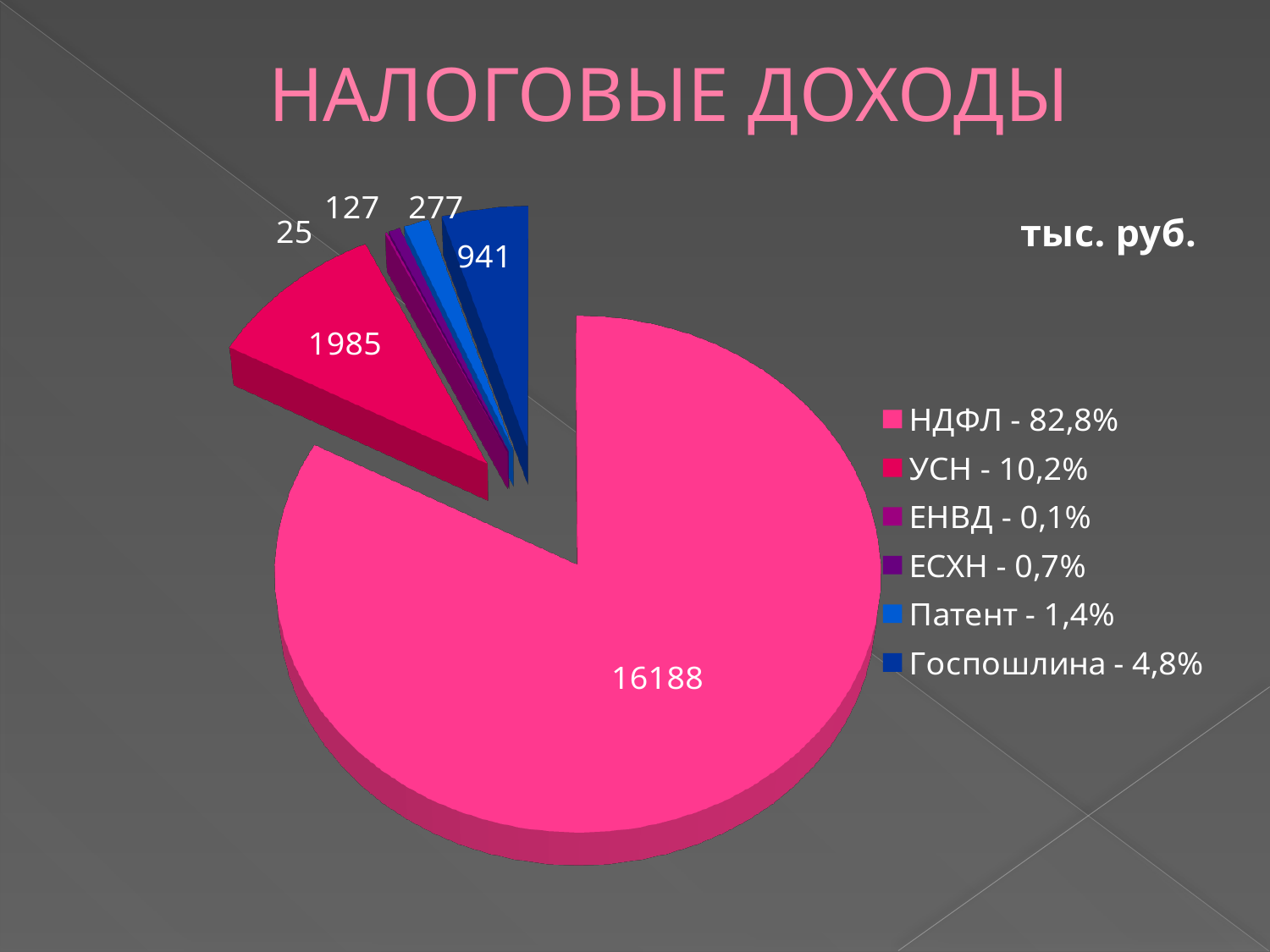
Which category has the largest slice of the pie? НДФЛ What is the value of the НДФЛ slice? 16188 What kind of chart is shown on the slide? pie chart Which is larger, the УСН slice or the Госпошлина slice? УСН What is the value of the УСН slice? 1985 What is the difference between the НДФЛ value and the УСН value? 14203 What is the title of the chart? тыс. руб. What share of the pie does Патент account for, according to the legend? 1,4% What is the value of the Госпошлина slice? 941 How many categories does the legend of the pie chart list? 6 Which category has the smallest slice of the pie? ЕНВД What share of the pie does НДФЛ account for, according to the legend? 82,8%